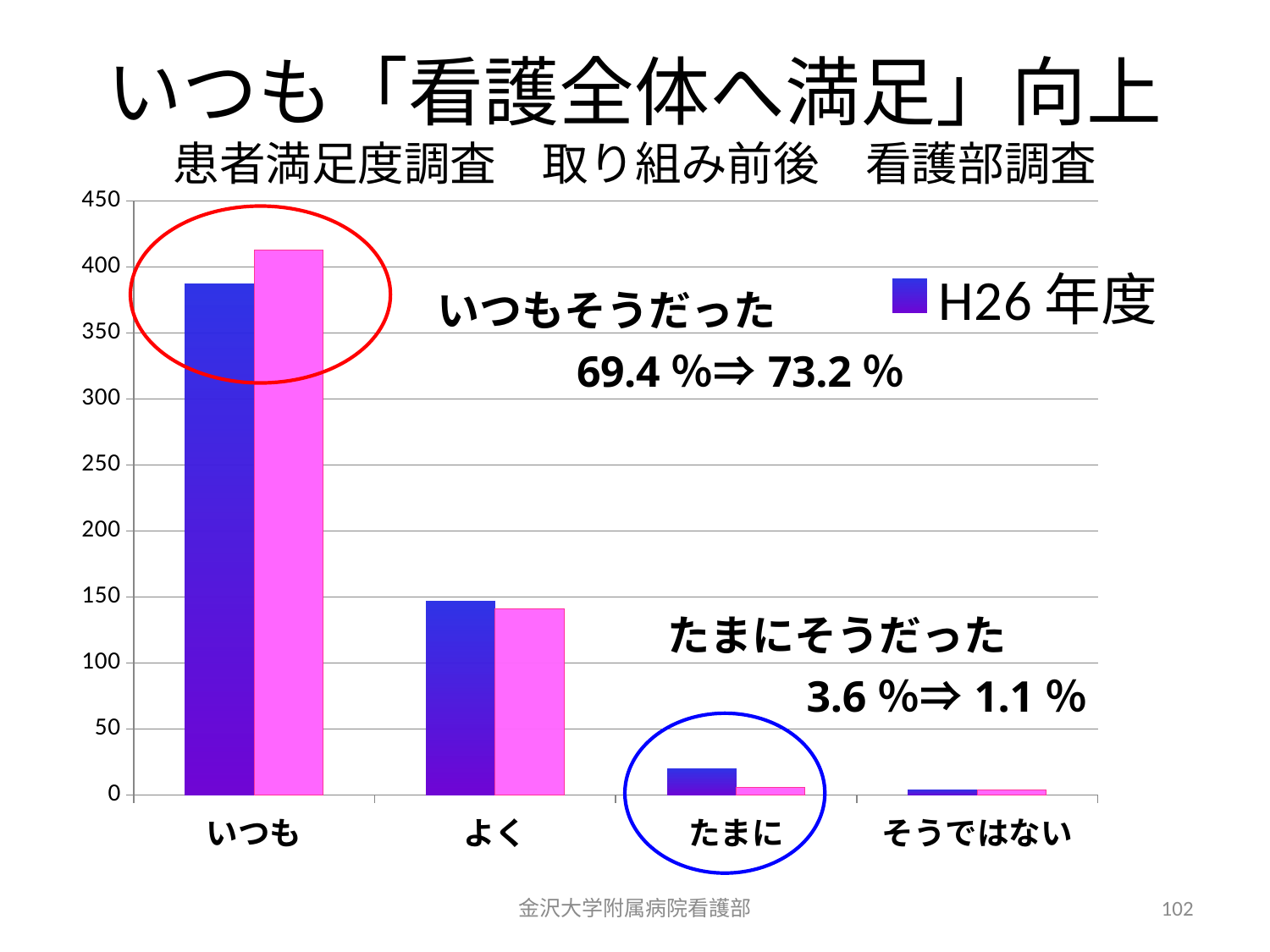
Do the bar values rise or fall moving from left to right across the categories? fall Is the value of the blue bar for いつも greater or less than 350? greater Is the value of the blue bar for たまに greater or less than 50? less How many categories are shown on the x axis of the chart? 4 Which category has the shortest bars in the chart? そうではない Is the value of the pink bar for いつも greater or less than 400? greater For the category いつも, is the blue bar or the pink bar taller? pink For the category たまに, is the blue bar or the pink bar taller? blue What series name is shown in the chart legend? H26 年度 What kind of chart is shown on the slide? bar chart Which category has the tallest bars in the chart? いつも